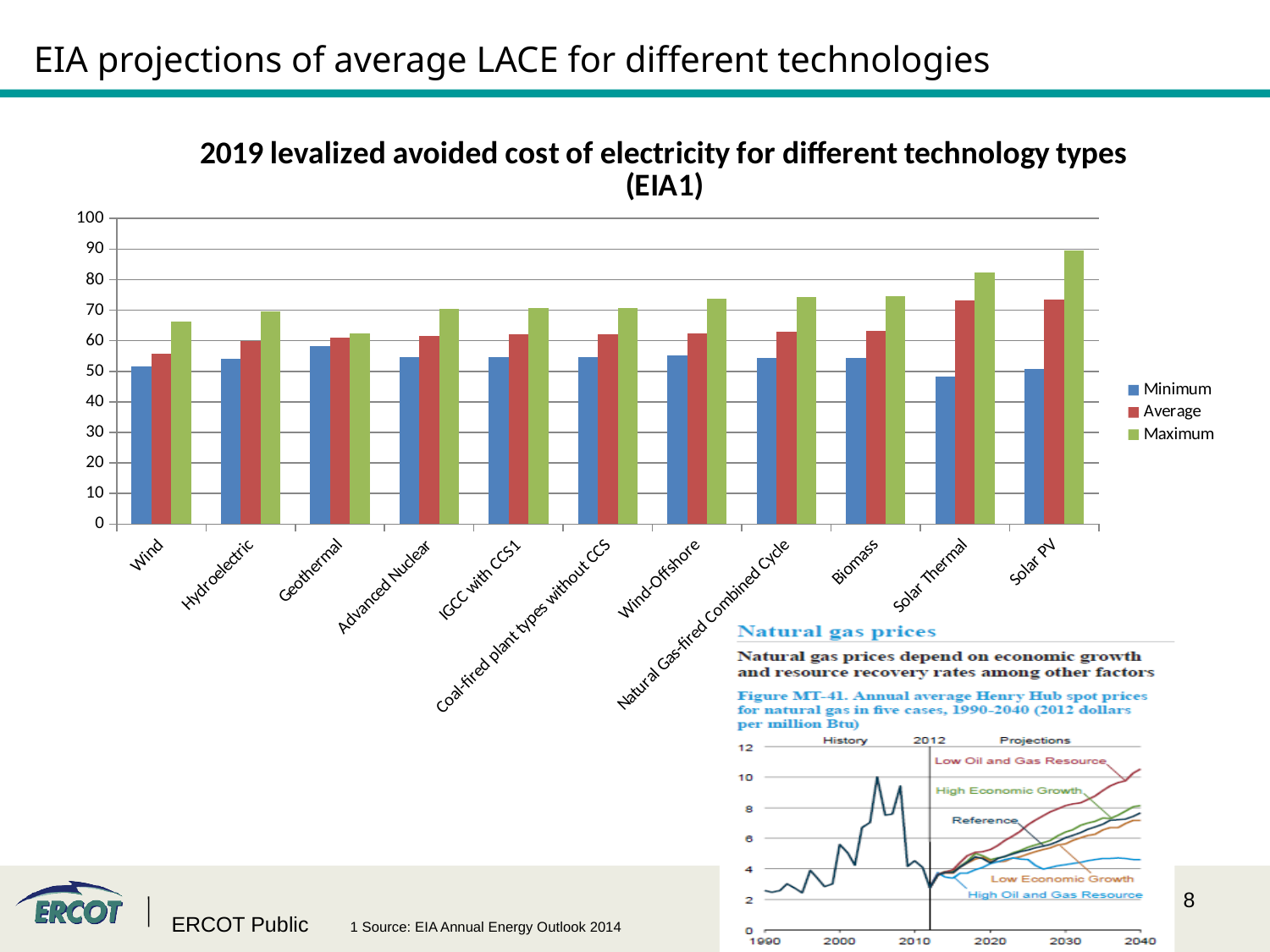
In the '2019 levalized avoided cost of electricity' bar chart, is the Maximum value for Solar PV greater or less than 80? greater In the '2019 levalized avoided cost of electricity' bar chart, what colour represents the Maximum series? green In the '2019 levalized avoided cost of electricity' bar chart, is the Maximum value for Wind greater or less than 60? greater In the '2019 levalized avoided cost of electricity' bar chart, is the Minimum value for Solar Thermal greater or less than 50? less In the '2019 levalized avoided cost of electricity' bar chart, how many technology types are shown on the x axis? 11 What kind of chart is the '2019 levalized avoided cost of electricity for different technology types (EIA1)' chart? bar chart What kind of chart is the 'Natural gas prices' chart in the lower right of the slide? line chart In the '2019 levalized avoided cost of electricity' bar chart, which technology has the lowest Maximum value? Geothermal In the '2019 levalized avoided cost of electricity' bar chart, which technology has the highest Maximum value? Solar PV In the '2019 levalized avoided cost of electricity' bar chart, which technology has the lowest Average value? Wind In the '2019 levalized avoided cost of electricity' bar chart, how many series does the legend list? 3 In the '2019 levalized avoided cost of electricity' bar chart, which is larger: the Minimum value for Geothermal or the Minimum value for Wind? Geothermal